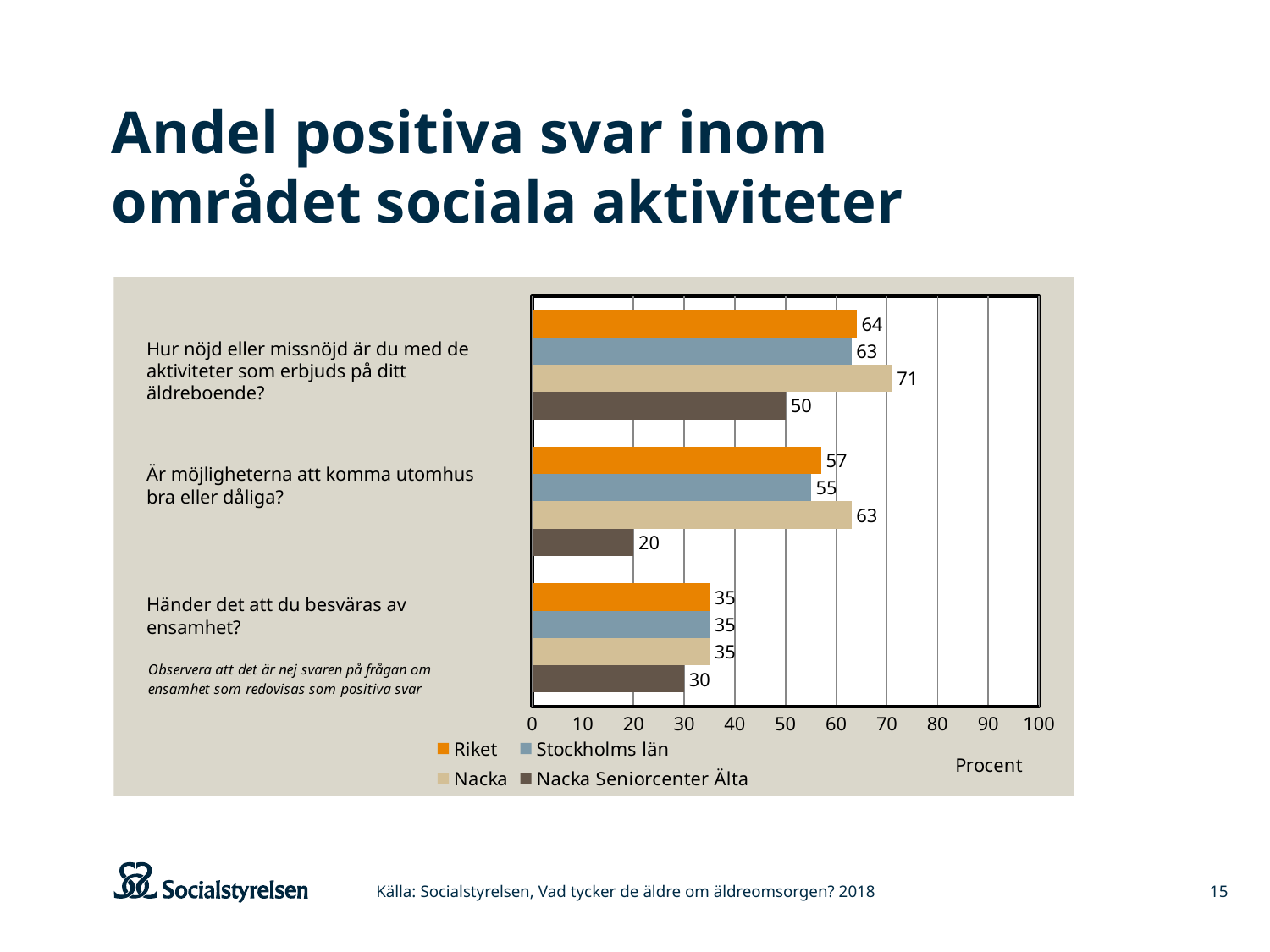
What is the value for Stockholms län on the question "Är möjligheterna att komma utomhus bra eller dåliga?"? 55 Which series has the highest value on the question "Hur nöjd eller missnöjd är du med de aktiviteter som erbjuds på ditt äldreboende?"? Nacka What is the value for Nacka on the question "Hur nöjd eller missnöjd är du med de aktiviteter som erbjuds på ditt äldreboende?"? 71 Which is larger on the question "Är möjligheterna att komma utomhus bra eller dåliga?": Riket or Nacka? Nacka How many questions (categories) are shown on the chart? 3 What is the label on the horizontal axis of the chart? Procent Which series has the lowest value on the question "Är möjligheterna att komma utomhus bra eller dåliga?"? Nacka Seniorcenter Älta What kind of chart is shown on the slide? Bar chart How many series does the legend list? 4 What is the value for Nacka Seniorcenter Älta on the question "Är möjligheterna att komma utomhus bra eller dåliga?"? 20 What is the value for Riket on the question "Händer det att du besväras av ensamhet?"? 35 What is the difference between Nacka and Nacka Seniorcenter Älta on the question "Hur nöjd eller missnöjd är du med de aktiviteter som erbjuds på ditt äldreboende?"? 21